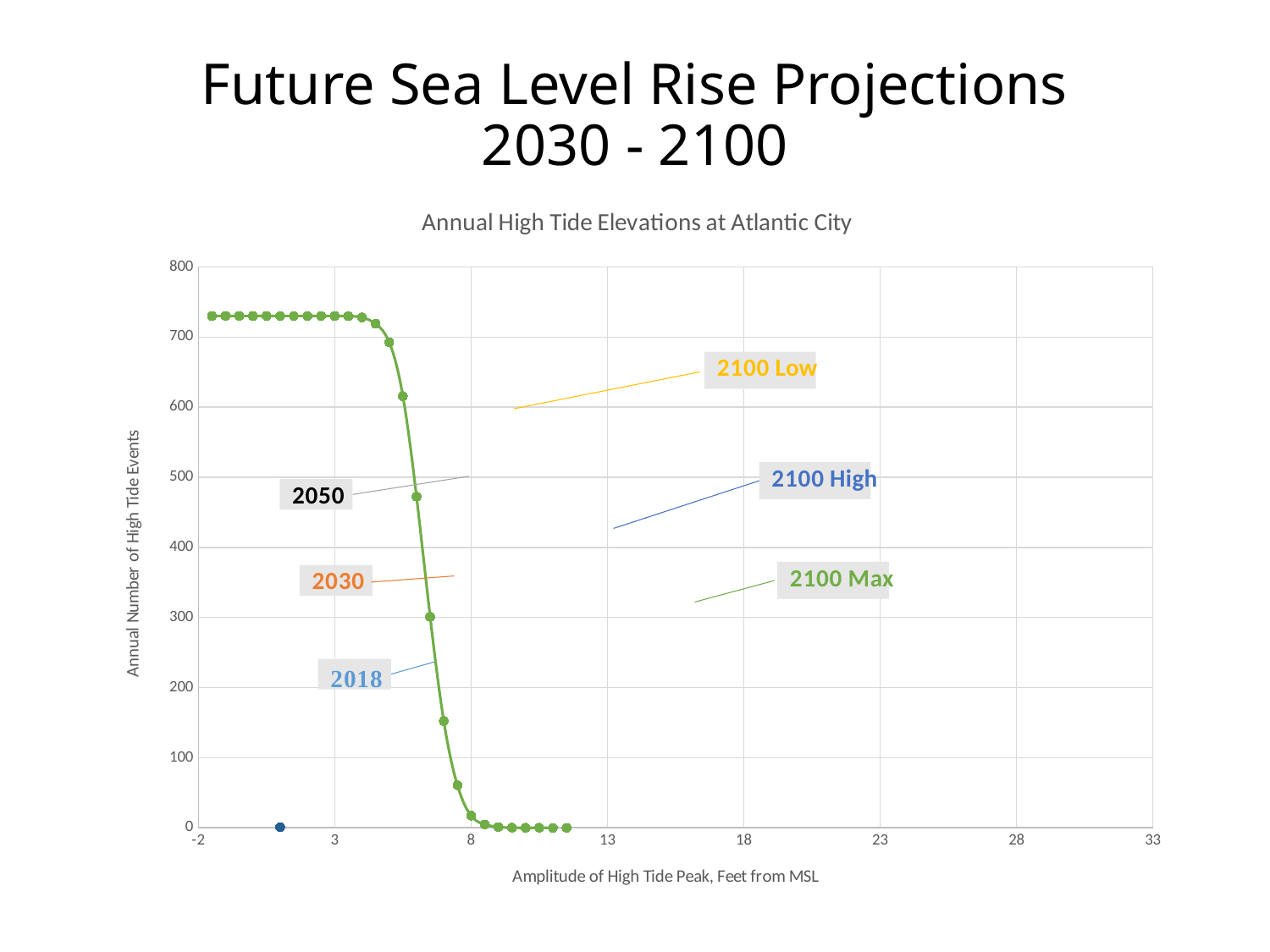
Is the annual number of high tide events at an amplitude of 3 feet greater or less than 700? greater What kind of chart is shown on the slide? line chart As the amplitude of the high tide peak increases along the x axis, do the annual number of high tide events rise or fall? fall What is the label of the x axis? Amplitude of High Tide Peak, Feet from MSL Is the annual number of high tide events at an amplitude of 3 feet greater or less than 800? less What is the title of the chart? Annual High Tide Elevations at Atlantic City Which is larger, the annual number of high tide events at an amplitude of 3 feet or at an amplitude of 8 feet? 3 feet Is the annual number of high tide events at an amplitude of 8 feet greater or less than 100? less